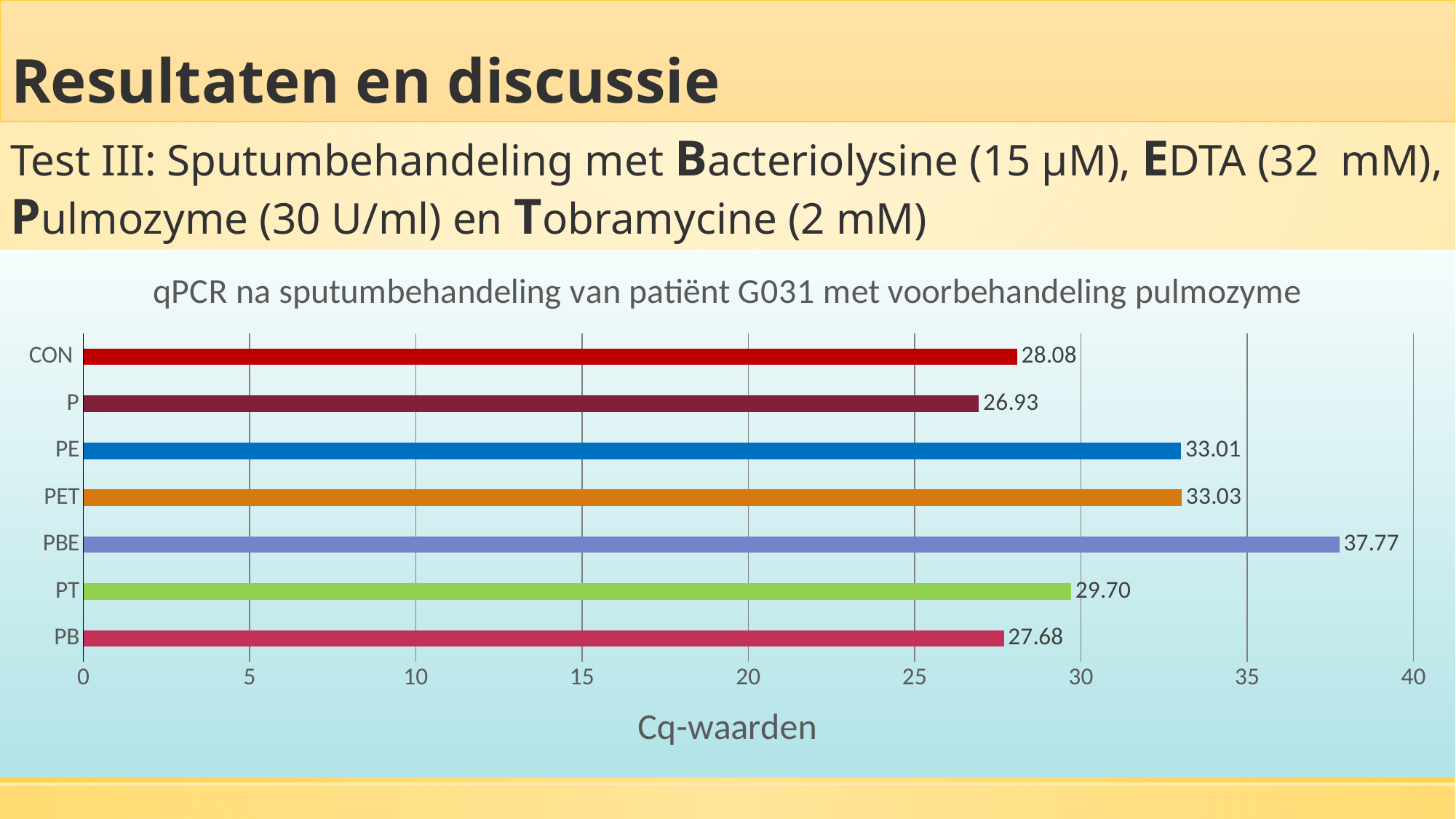
What is the Cq value for PBE? 37.77 Which has a larger Cq value, PT or PB? PT Is the value for PE greater or less than 30? greater What is the difference between the Cq values of PBE and P? 10.84 What is the Cq value for CON? 28.08 How many categories are shown in the chart? 7 Which category has the lowest Cq value? P What is the difference between the Cq values of CON and PB? 0.40 What is the title of the chart? qPCR na sputumbehandeling van patiënt G031 met voorbehandeling pulmozyme Which category has the highest Cq value? PBE What kind of chart is shown on the slide? bar chart What is the Cq value for PT? 29.70